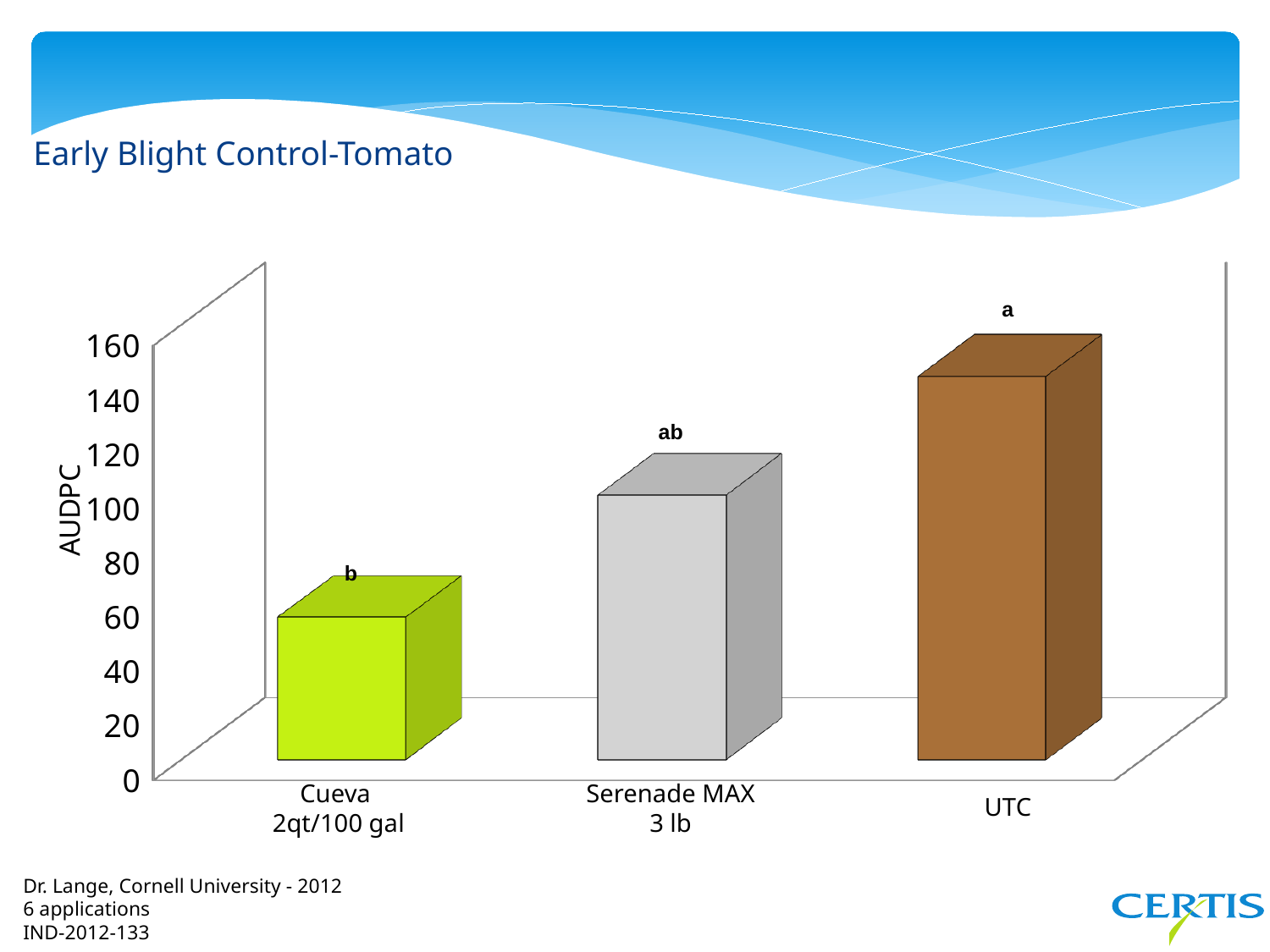
Is the AUDPC value for Serenade MAX 3 lb greater or less than 120? less What letter is printed above the UTC bar? a What kind of chart is shown on the slide? bar chart Which has a larger AUDPC value, Serenade MAX 3 lb or UTC? UTC Which has a larger AUDPC value, Cueva 2qt/100 gal or Serenade MAX 3 lb? Serenade MAX 3 lb Is the AUDPC value for UTC greater or less than 120? greater Which category has the highest AUDPC value? UTC Is the AUDPC value for Serenade MAX 3 lb greater or less than 80? greater How many treatment categories are plotted on the chart? 3 Which category has the lowest AUDPC value? Cueva 2qt/100 gal What is the label on the vertical axis of the chart? AUDPC